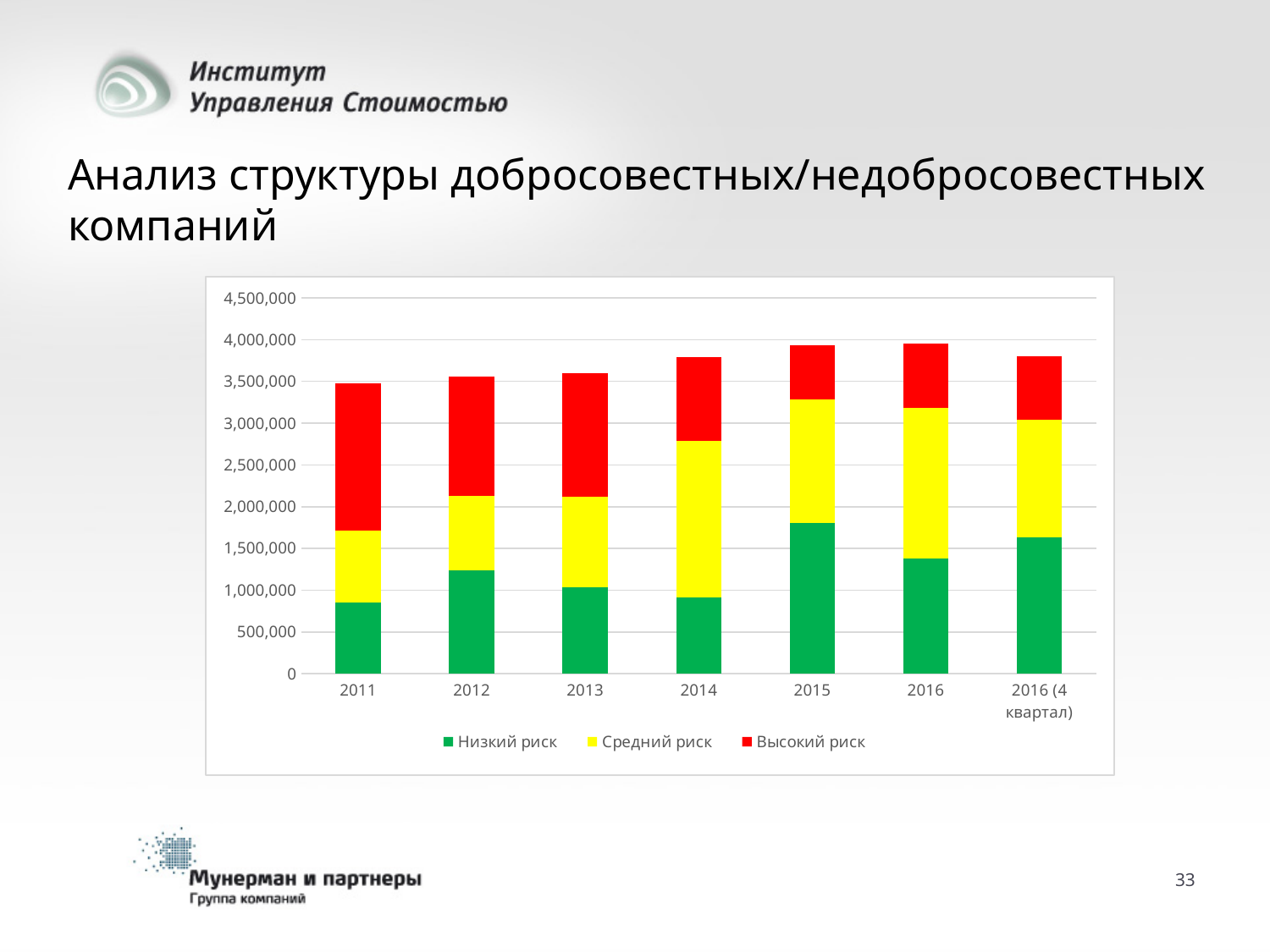
How many series does the chart's legend list? 3 Which colour represents the series Высокий риск in the chart? Red Which category has the lowest total stacked bar? 2011 Is the value of Низкий риск for 2015 greater or less than 1,500,000? greater Which is larger, the Низкий риск value for 2012 or for 2013? 2012 Is the value of Низкий риск for 2011 greater or less than 1,000,000? less Which category has the highest value for Низкий риск? 2015 What are the three series listed in the chart's legend? Низкий риск, Средний риск, Высокий риск What kind of chart is shown on the slide? Stacked bar chart Is the total of the stacked bar for 2014 greater or less than 3,500,000? greater How many categories are shown on the x axis of the chart? 7